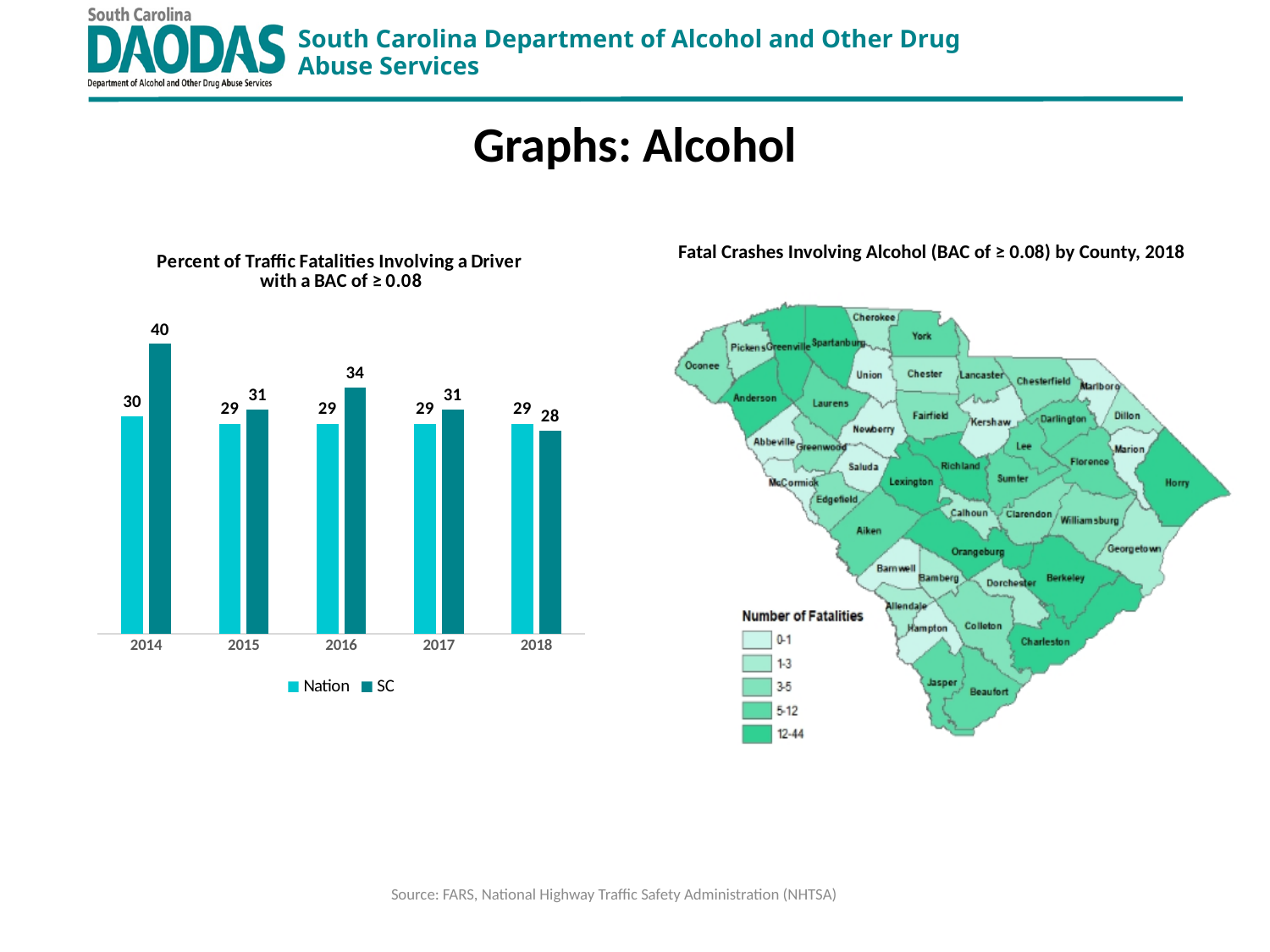
In the chart 'Percent of Traffic Fatalities Involving a Driver with a BAC of ≥ 0.08', what are the two legend entries? Nation and SC In the chart 'Percent of Traffic Fatalities Involving a Driver with a BAC of ≥ 0.08', which year has the highest SC value? 2014 In the chart 'Percent of Traffic Fatalities Involving a Driver with a BAC of ≥ 0.08', what is the SC value for 2014? 40 What kind of chart is 'Percent of Traffic Fatalities Involving a Driver with a BAC of ≥ 0.08'? Bar chart In the chart 'Percent of Traffic Fatalities Involving a Driver with a BAC of ≥ 0.08', which year has the lowest SC value? 2018 In the chart 'Percent of Traffic Fatalities Involving a Driver with a BAC of ≥ 0.08', how many series does the legend list? 2 In the chart 'Percent of Traffic Fatalities Involving a Driver with a BAC of ≥ 0.08', what is the SC value for 2018? 28 In the chart 'Percent of Traffic Fatalities Involving a Driver with a BAC of ≥ 0.08', which is larger in 2018, the Nation value or the SC value? Nation In the chart 'Percent of Traffic Fatalities Involving a Driver with a BAC of ≥ 0.08', how many years are shown on the x axis? 5 In the chart 'Percent of Traffic Fatalities Involving a Driver with a BAC of ≥ 0.08', what is the difference between the SC and Nation values in 2014? 10 In the chart 'Percent of Traffic Fatalities Involving a Driver with a BAC of ≥ 0.08', what is the difference between the SC values for 2016 and 2017? 3 In the chart 'Percent of Traffic Fatalities Involving a Driver with a BAC of ≥ 0.08', what is the Nation value for 2016? 29